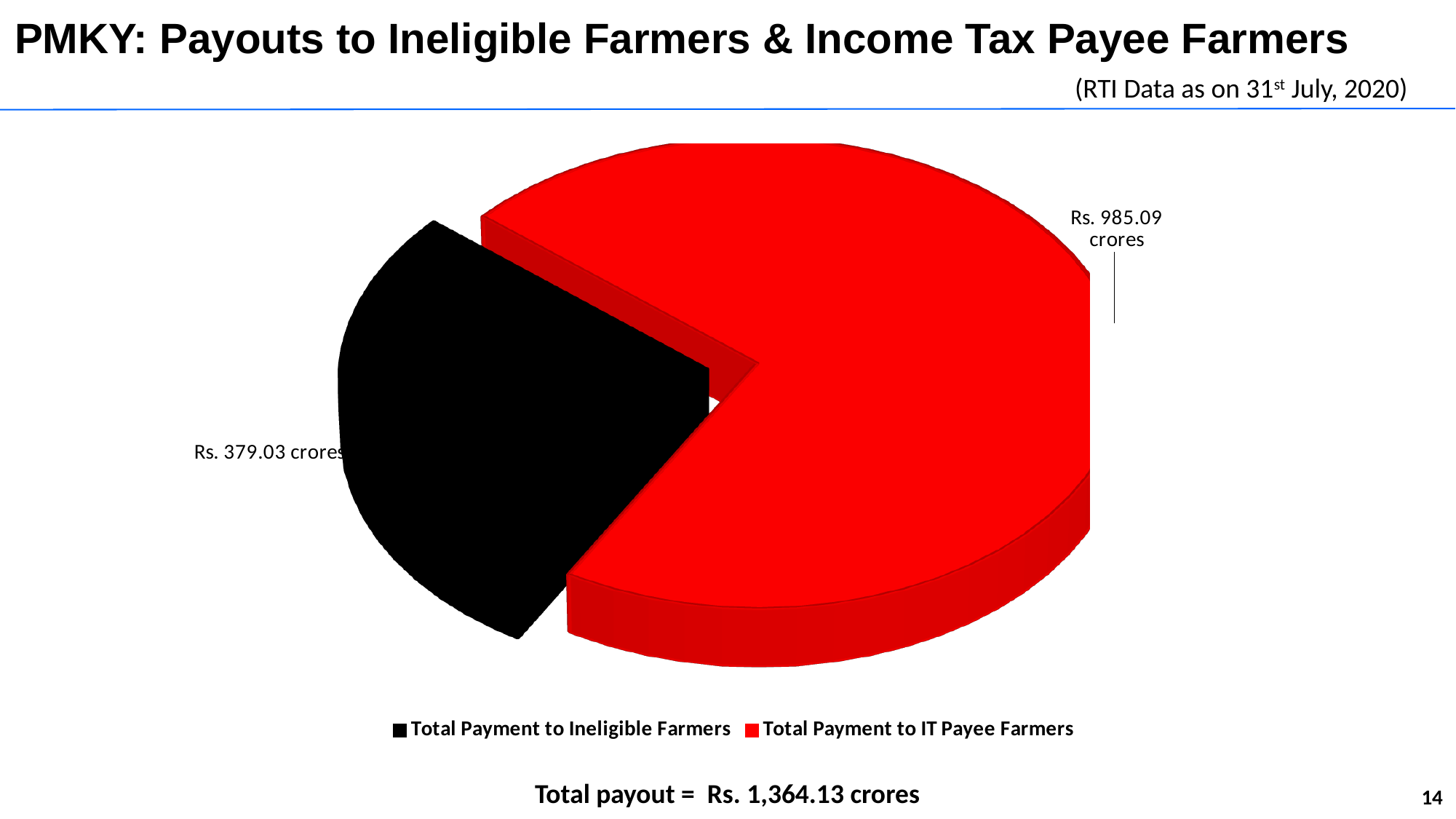
What is the total payment to ineligible farmers shown on the pie chart? Rs. 379.03 crores How many slices does the pie chart have? 2 What kind of chart is shown on the slide? pie chart Which category received the smaller payout on the pie chart? Total Payment to Ineligible Farmers By how much does the payment to IT payee farmers exceed the payment to ineligible farmers? Rs. 606.06 crores What is the total payout stated on the slide? Rs. 1,364.13 crores Is the payment to ineligible farmers larger or smaller than the payment to IT payee farmers? smaller What is the total payment to IT payee farmers shown on the pie chart? Rs. 985.09 crores Which colour represents Total Payment to IT Payee Farmers in the legend? red Which category received the larger payout, ineligible farmers or IT payee farmers? Total Payment to IT Payee Farmers